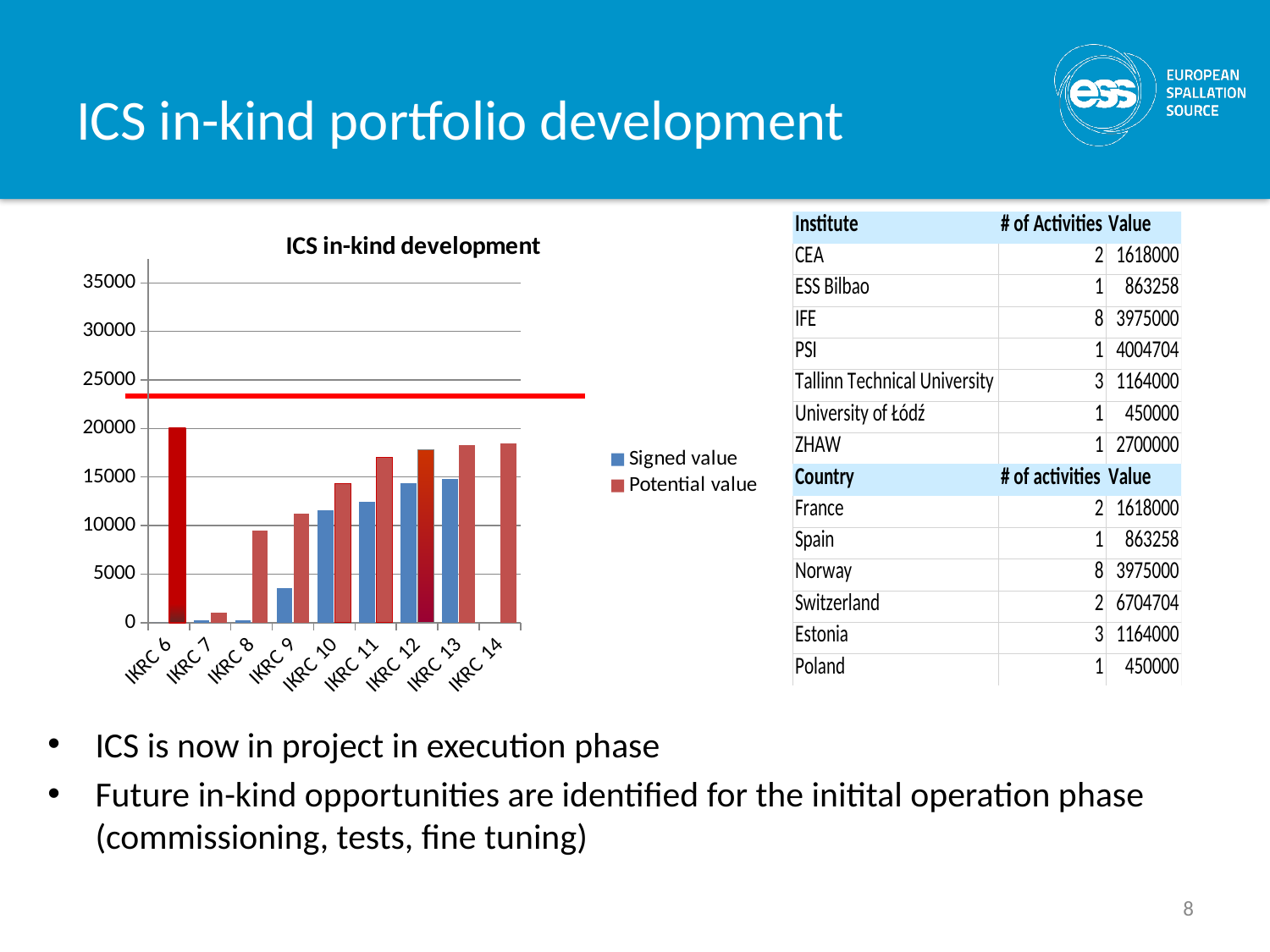
What kind of chart is shown on the slide? bar chart Is the Potential value for IKRC 11 greater or less than 15000? greater What is the title of the chart on the slide? ICS in-kind development Is the Signed value for IKRC 9 greater or less than 5000? less Which category has the highest Potential value? IKRC 6 Which category has the lowest Potential value? IKRC 7 Is the Signed value for IKRC 10 greater or less than 10000? greater How many categories are shown on the x axis of the chart? 9 Which colour represents the Signed value series in the chart? blue For IKRC 9, which is larger: the Signed value or the Potential value? Potential value How many series does the chart's legend list? 2